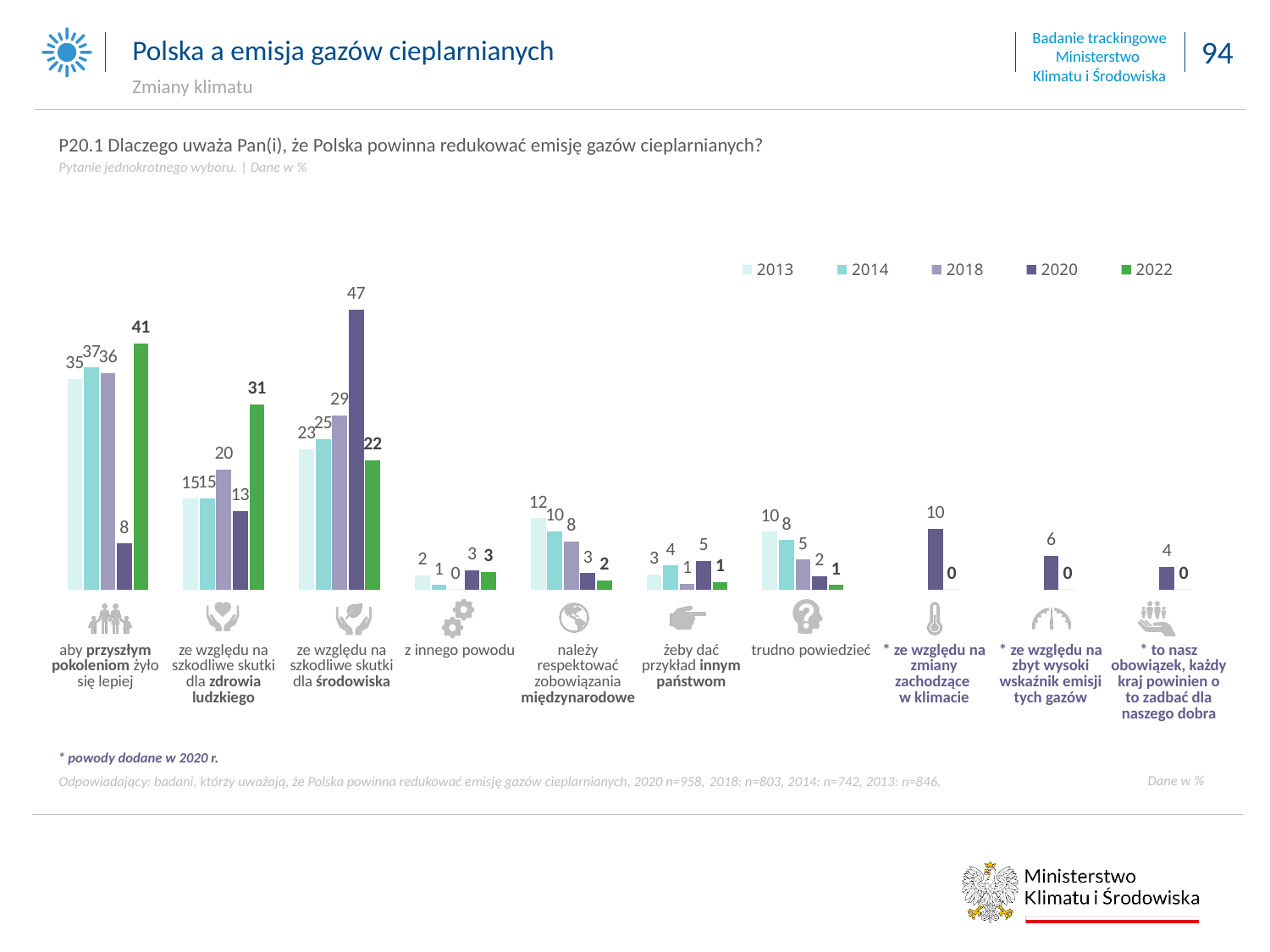
What is the 2022 value for 'aby przyszłym pokoleniom żyło się lepiej'? 41 What is the difference between the 2022 and 2020 values for 'aby przyszłym pokoleniom żyło się lepiej'? 33 What is the 2022 value for 'trudno powiedzieć'? 1 Which category has the lowest 2013 value? z innego powodu Which is larger for 'należy respektować zobowiązania międzynarodowe': the 2013 value or the 2022 value? 2013 How many series does the legend list? 5 What is the 2020 value for 'ze względu na zmiany zachodzące w klimacie'? 10 What is the 2020 value for 'ze względu na szkodliwe skutki dla środowiska'? 47 Which year does the green series in the legend represent? 2022 Which category has the highest 2020 value? ze względu na szkodliwe skutki dla środowiska What is the 2018 value for 'ze względu na szkodliwe skutki dla zdrowia ludzkiego'? 20 What kind of chart is shown on the slide? bar chart